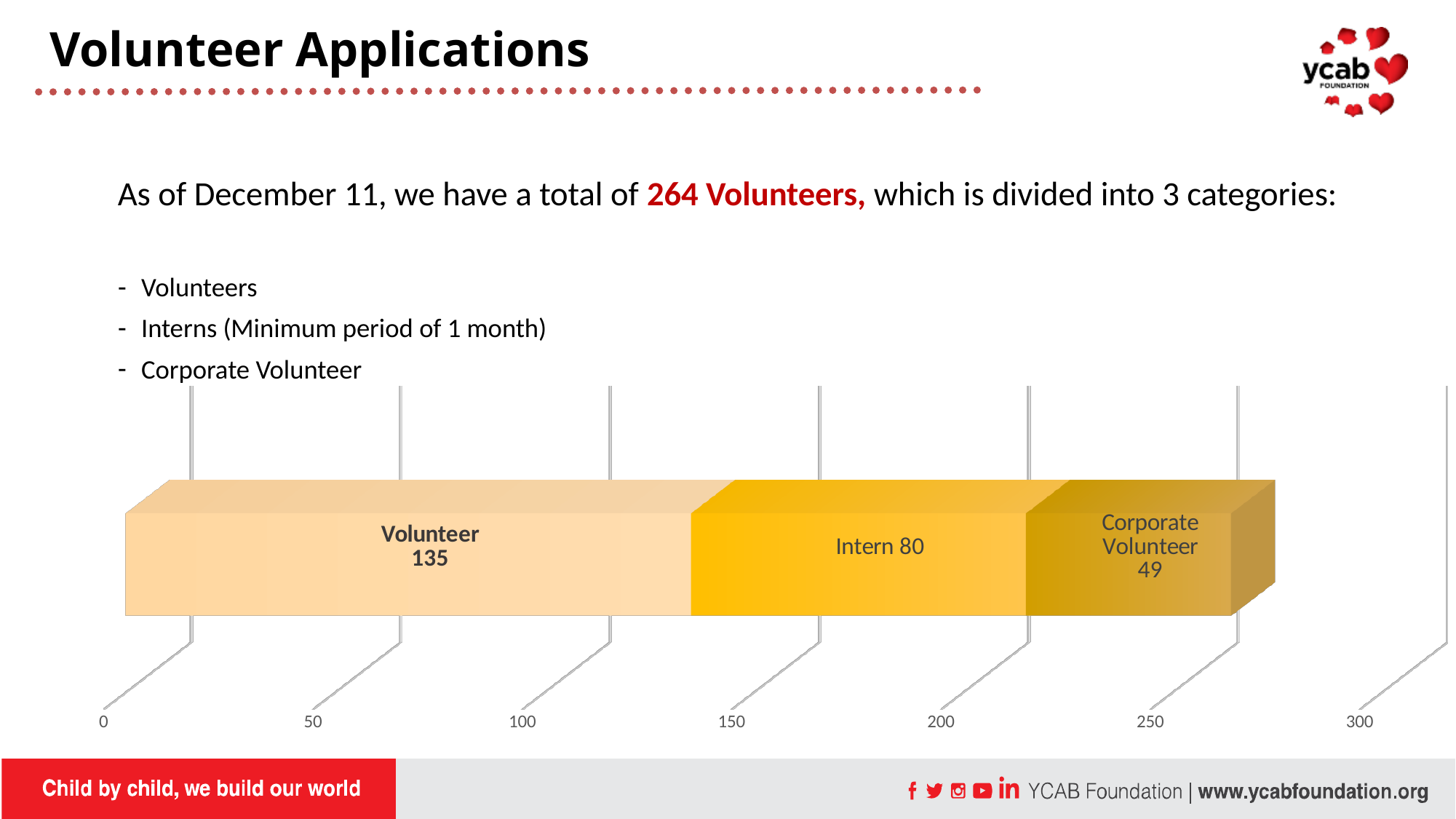
What is the value for the Volunteer segment of the stacked bar? 135 What is the difference between the Volunteer value and the Intern value? 55 What is the difference between the Intern value and the Corporate Volunteer value? 31 What is the value for the Intern segment of the stacked bar? 80 How many segments make up the stacked bar? 3 What kind of chart is shown on the slide? Stacked bar chart What is the total of the stacked bar? 264 Which segment of the stacked bar has the lowest value? Corporate Volunteer Which is larger, the Intern value or the Corporate Volunteer value? Intern What is the value for the Corporate Volunteer segment of the stacked bar? 49 Which segment of the stacked bar has the highest value? Volunteer What is the highest value shown on the horizontal axis of the chart? 300